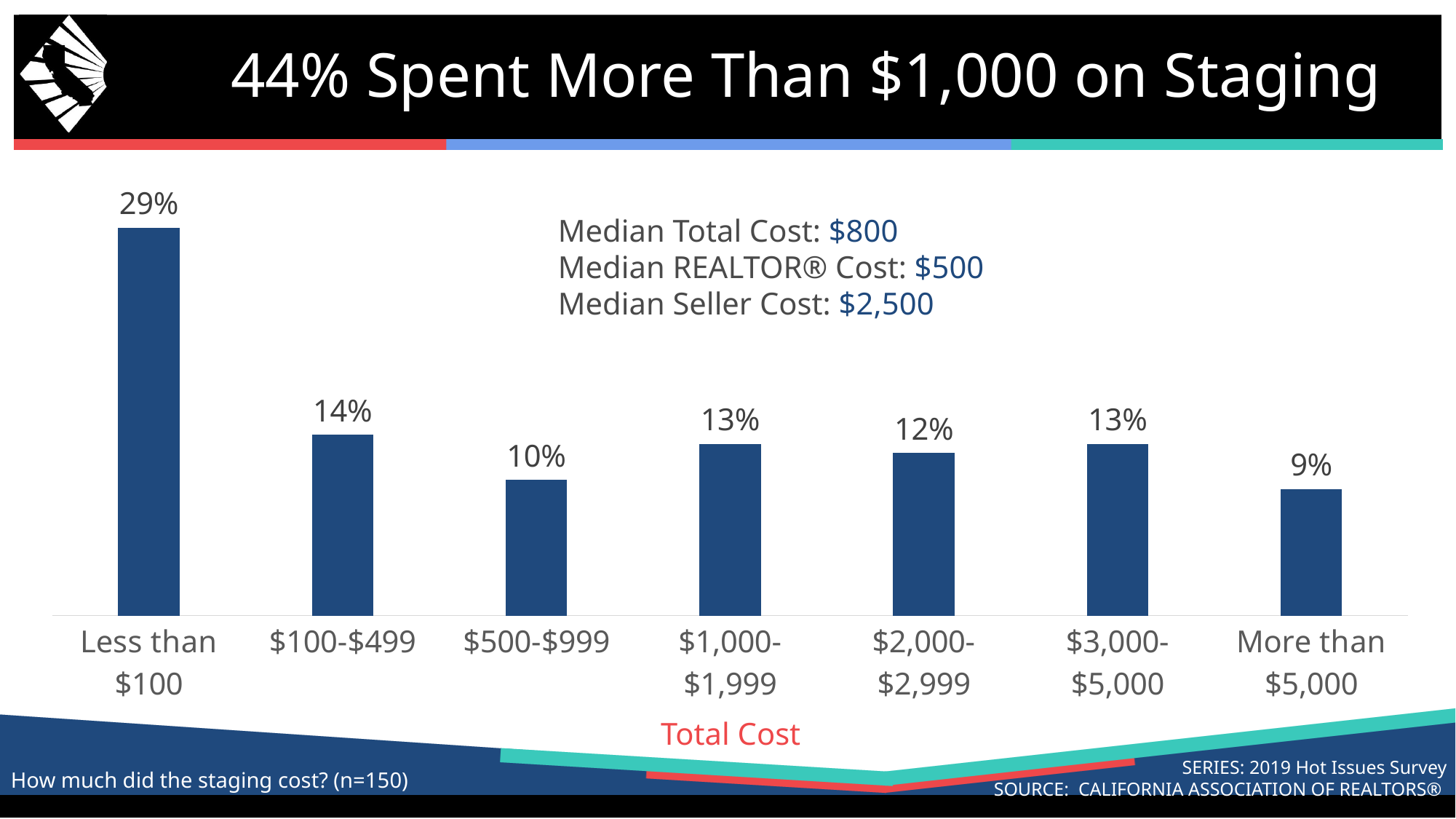
Which cost category has the highest percentage? Less than $100 What is the value for the $500-$999 category? 10% What is the x-axis title of the chart? Total Cost How many cost categories are shown on the x axis? 7 What is the median total cost stated on the slide? $800 Which cost category has the lowest percentage? More than $5,000 What is the difference between the Less than $100 and $100-$499 categories? 15% What is the value for the $2,000-$2,999 category? 12% What kind of chart is shown on the slide? Bar chart Which is larger, the value for $100-$499 or the value for $500-$999? $100-$499 What percentage spent more than $5,000 on staging? 9% What percentage of respondents spent less than $100 on staging? 29%